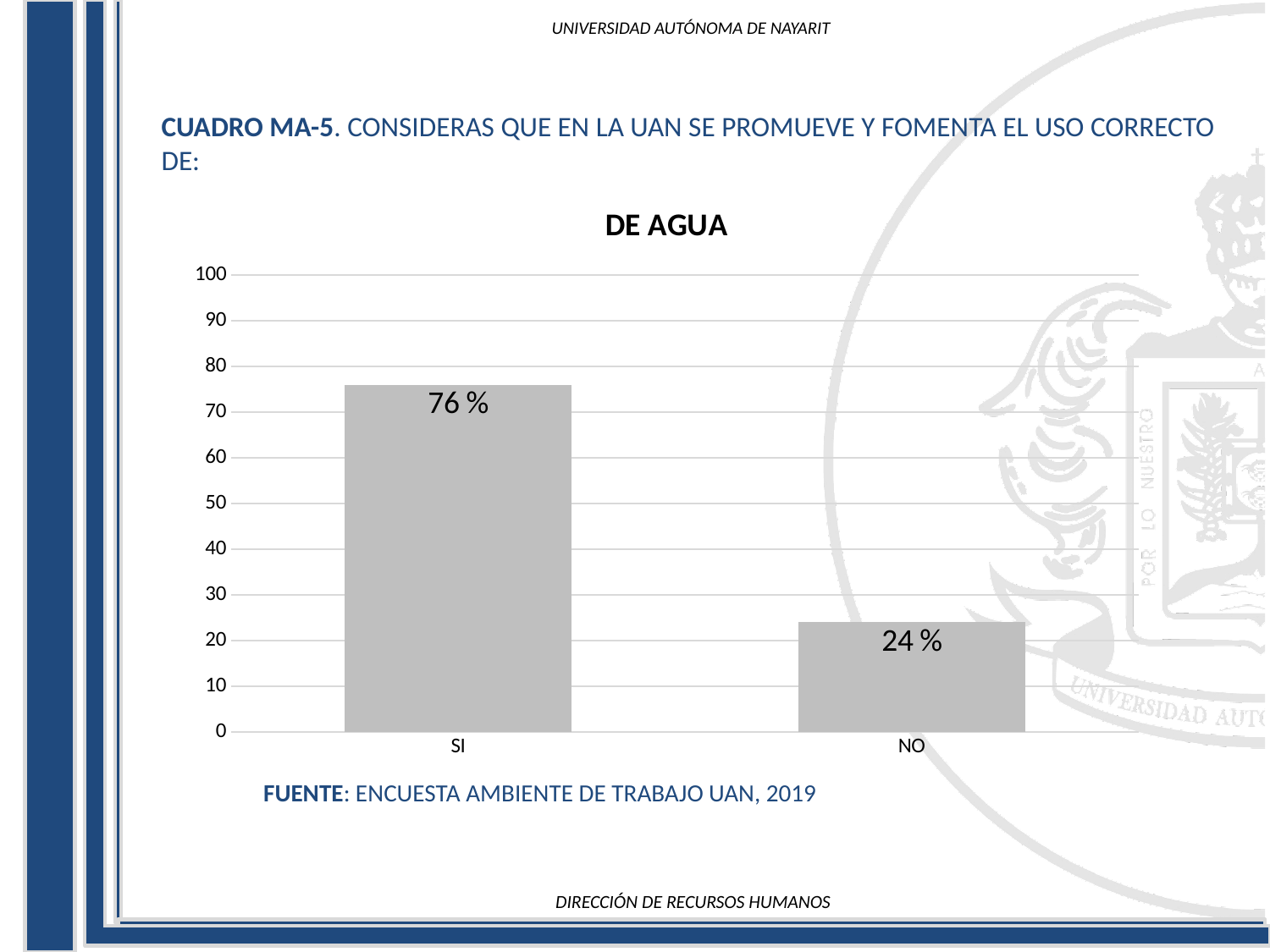
What is the value for SI? 76 % Which category has the highest value? SI What is the title of the chart? DE AGUA Is the value for NO greater or less than 30? less What is the highest value shown on the y axis? 100 What is the difference between the values for SI and NO? 52 % Which category has the lowest value? NO Which is larger, the value for SI or the value for NO? SI What kind of chart is shown? bar chart What is the value for NO? 24 % How many categories are shown on the x axis? 2 Is the value for SI greater or less than 70? greater